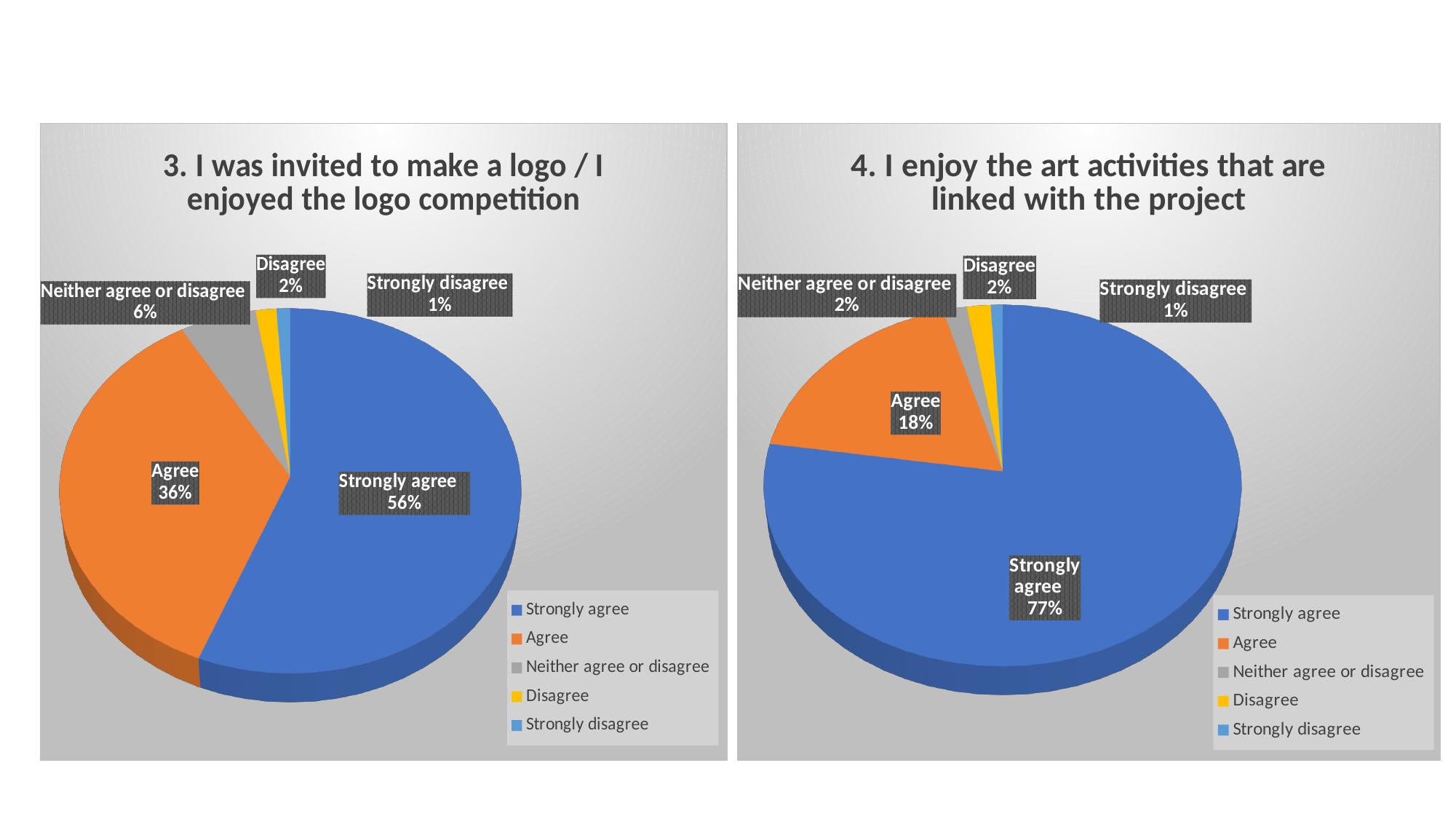
How many response categories does the legend of the left chart (3. I was invited to make a logo / I enjoyed the logo competition) list? 5 In the right chart (4. I enjoy the art activities that are linked with the project), what percentage chose Strongly agree? 77% In the left chart (3. I was invited to make a logo / I enjoyed the logo competition), what percentage of respondents chose Strongly agree? 56% What type of chart is used for question 4 (I enjoy the art activities that are linked with the project)? Pie chart In the right chart (4. I enjoy the art activities that are linked with the project), what is the difference in percentage points between Strongly agree and Agree? 59 In the right chart (4. I enjoy the art activities that are linked with the project), what colour represents Disagree? Yellow In the left chart (3. I was invited to make a logo / I enjoyed the logo competition), what is the difference in percentage points between Strongly agree and Agree? 20 In the right chart (4. I enjoy the art activities that are linked with the project), which response has the smallest share? Strongly disagree In the left chart (3. I was invited to make a logo / I enjoyed the logo competition), which response has the largest share? Strongly agree In the left chart (3. I was invited to make a logo / I enjoyed the logo competition), what percentage chose Neither agree or disagree? 6% Which chart has the larger share for Agree, the left chart (question 3) or the right chart (question 4)? The left chart (question 3) In the right chart (4. I enjoy the art activities that are linked with the project), what percentage of respondents chose Agree? 18%